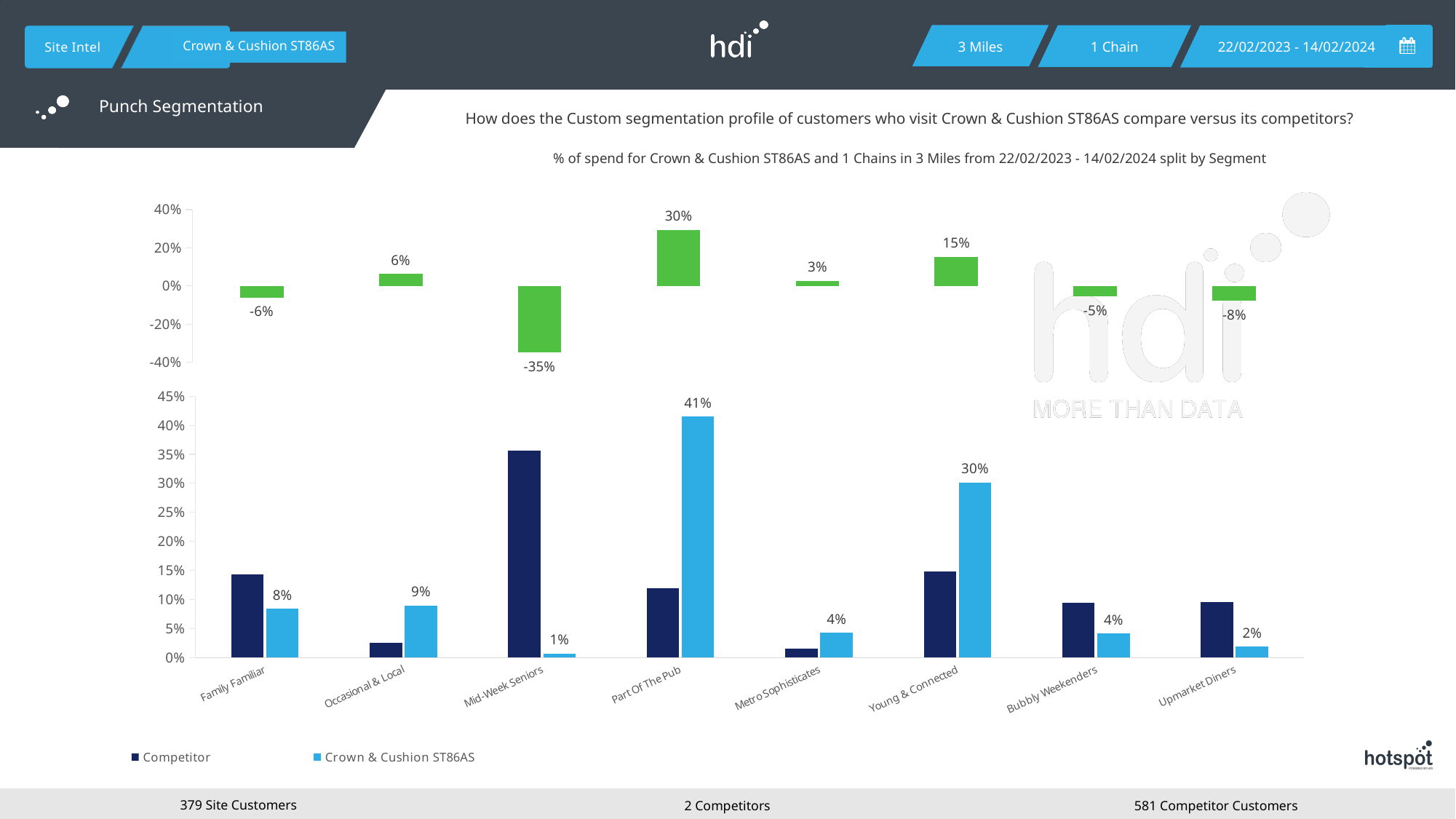
In the bottom chart, what is the value for Crown & Cushion ST86AS in the Part Of The Pub segment? 41% In the top chart, which segment has the highest value? Part Of The Pub How many series does the legend of the bottom chart list? 2 In the bottom chart, for Mid-Week Seniors, which is larger: the Competitor value or the Crown & Cushion ST86AS value? Competitor In the bottom chart, is the Competitor value for Occasional & Local greater or less than 5%? less What type of chart is the bottom chart? Bar chart In the bottom chart, which segment has the lowest value for Crown & Cushion ST86AS? Mid-Week Seniors In the bottom chart, what is the difference between the Crown & Cushion ST86AS values for Part Of The Pub and Young & Connected? 11% In the top chart, what is the value shown for Mid-Week Seniors? -35% In the top chart, which segment has the lowest value? Mid-Week Seniors How many segments are shown on the x axis of the bottom chart? 8 In the bottom chart, is the Competitor value for Mid-Week Seniors greater or less than 30%? greater